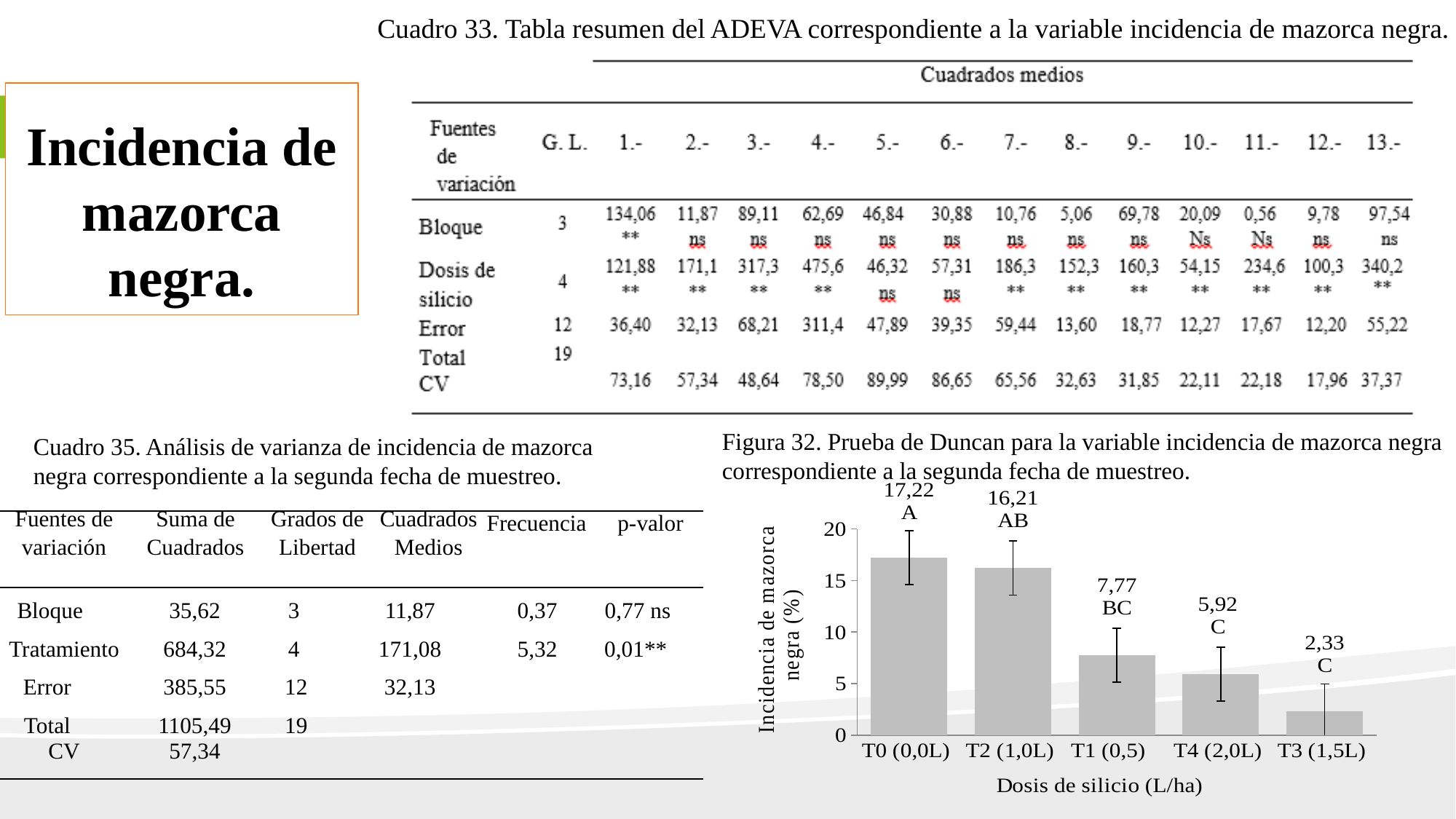
In Figura 32, what is the value for T2 (1,0L)? 16,21 In Figura 32, how many bars are plotted? 5 In Figura 32, which treatment has the highest incidence of black pod? T0 (0,0L) In Figura 32, do the values rise or fall from left to right along the x axis? fall In Figura 32, what is the difference between the values for T0 (0,0L) and T3 (1,5L)? 14,89 In Figura 32, what is the value for T3 (1,5L)? 2,33 In Figura 32, which is larger, the value for T1 (0,5) or the value for T4 (2,0L)? T1 (0,5) In Figura 32, what is the value for T1 (0,5)? 7,77 In Figura 32, what is the label of the y axis? Incidencia de mazorca negra (%) In Figura 32, which treatment has the lowest incidence of black pod? T3 (1,5L) In Figura 32, what is the value for T0 (0,0L)? 17,22 What type of chart is Figura 32? bar chart